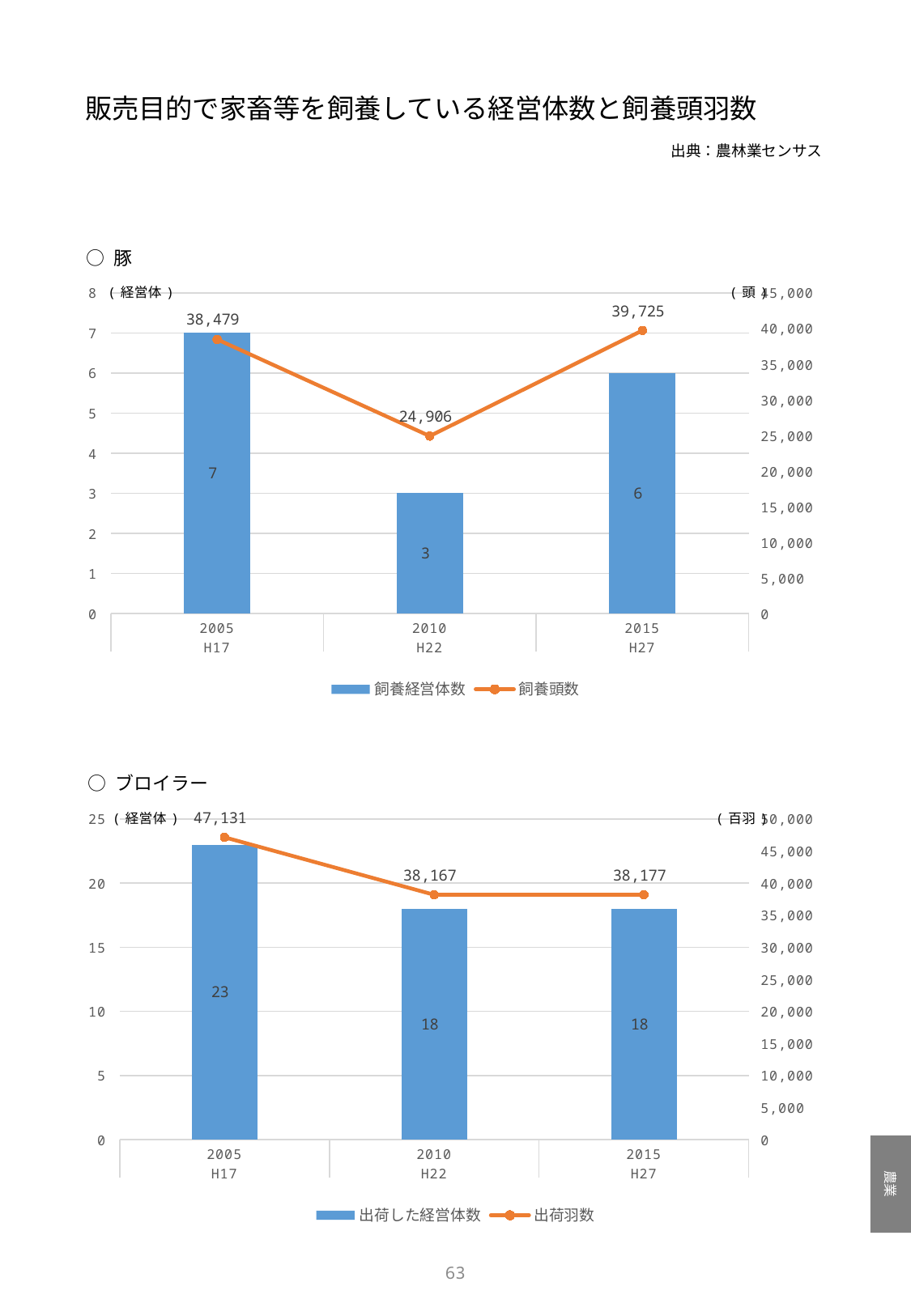
In the 豚 chart, what colour is the 飼養頭数 line? Orange In the ブロイラー chart, how many series does the legend list? 2 In the ブロイラー chart, what is the value of 出荷した経営体数 for 2015 (H27)? 18 In the 豚 chart, which year has the highest 飼養経営体数? 2005 (H17) In the 豚 chart, what is the value of 飼養頭数 for 2015 (H27)? 39,725 In the ブロイラー chart, what is the difference in 出荷した経営体数 between 2005 (H17) and 2010 (H22)? 5 In the 豚 chart, what is the difference in 飼養頭数 between 2015 (H27) and 2010 (H22)? 14,819 In the 豚 chart, which year has the lowest 飼養頭数? 2010 (H22) In the ブロイラー chart, which is larger, the 出荷羽数 for 2005 (H17) or for 2010 (H22)? 2005 (H17) In the ブロイラー chart, what is the value of 出荷羽数 for 2005 (H17)? 47,131 In the 豚 chart, what is the value of 飼養経営体数 for 2010 (H22)? 3 How many years are shown on the x axis of the 豚 chart? 3